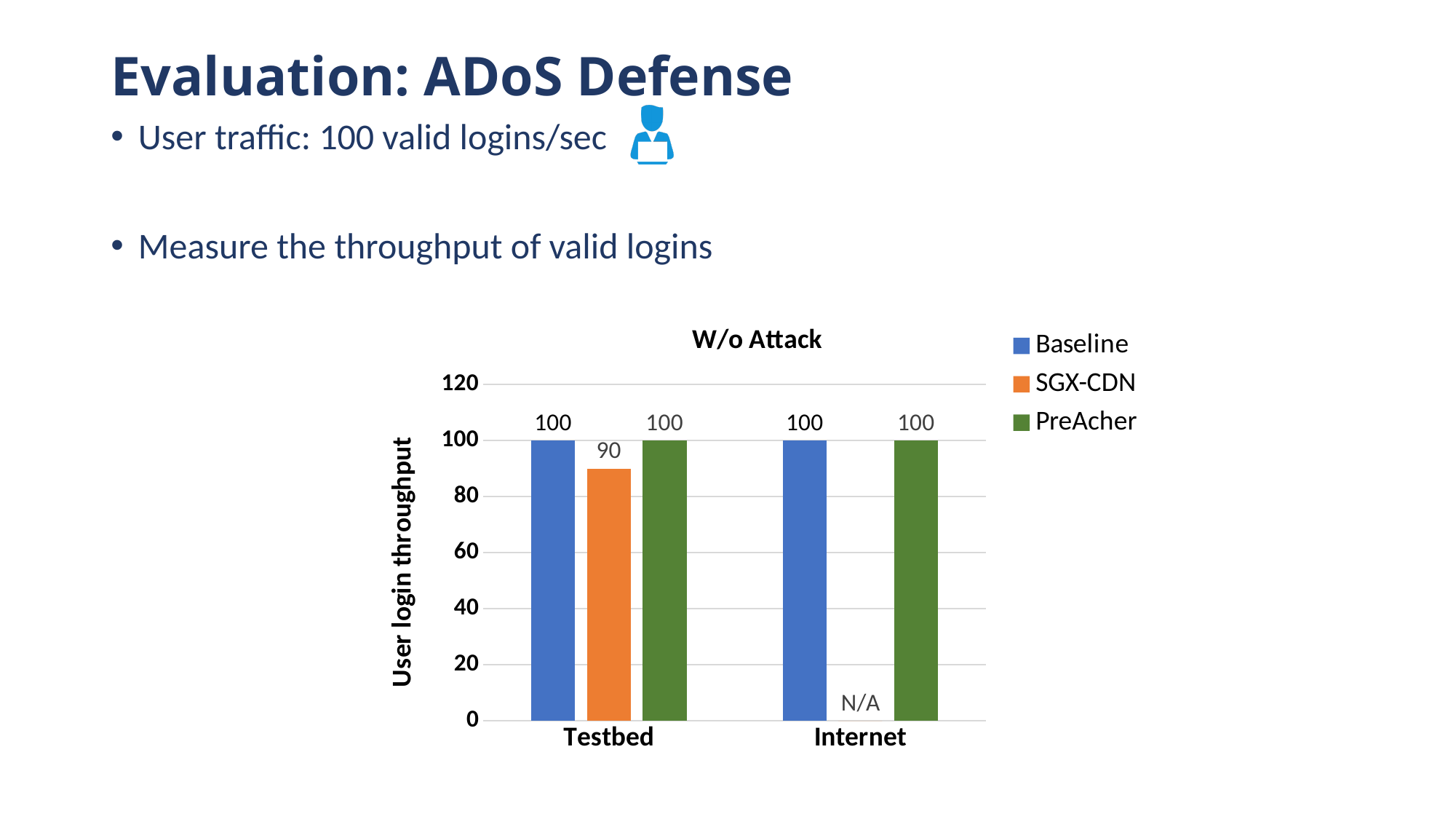
What is the difference between the Baseline and SGX-CDN values in the Testbed category? 10 Which series has the lowest value in the Testbed category? SGX-CDN What is the user login throughput for SGX-CDN in the Testbed category? 90 What is the user login throughput for PreAcher in the Testbed category? 100 What is the user login throughput for Baseline in the Internet category? 100 What kind of chart is shown on the slide? bar chart What is the title of the chart? W/o Attack In the Testbed category, which is larger: the PreAcher value or the SGX-CDN value? PreAcher How many categories are shown on the x axis? 2 Is the value for SGX-CDN in the Testbed category greater or less than 80? greater What label is shown for SGX-CDN in the Internet category? N/A How many series does the legend list? 3